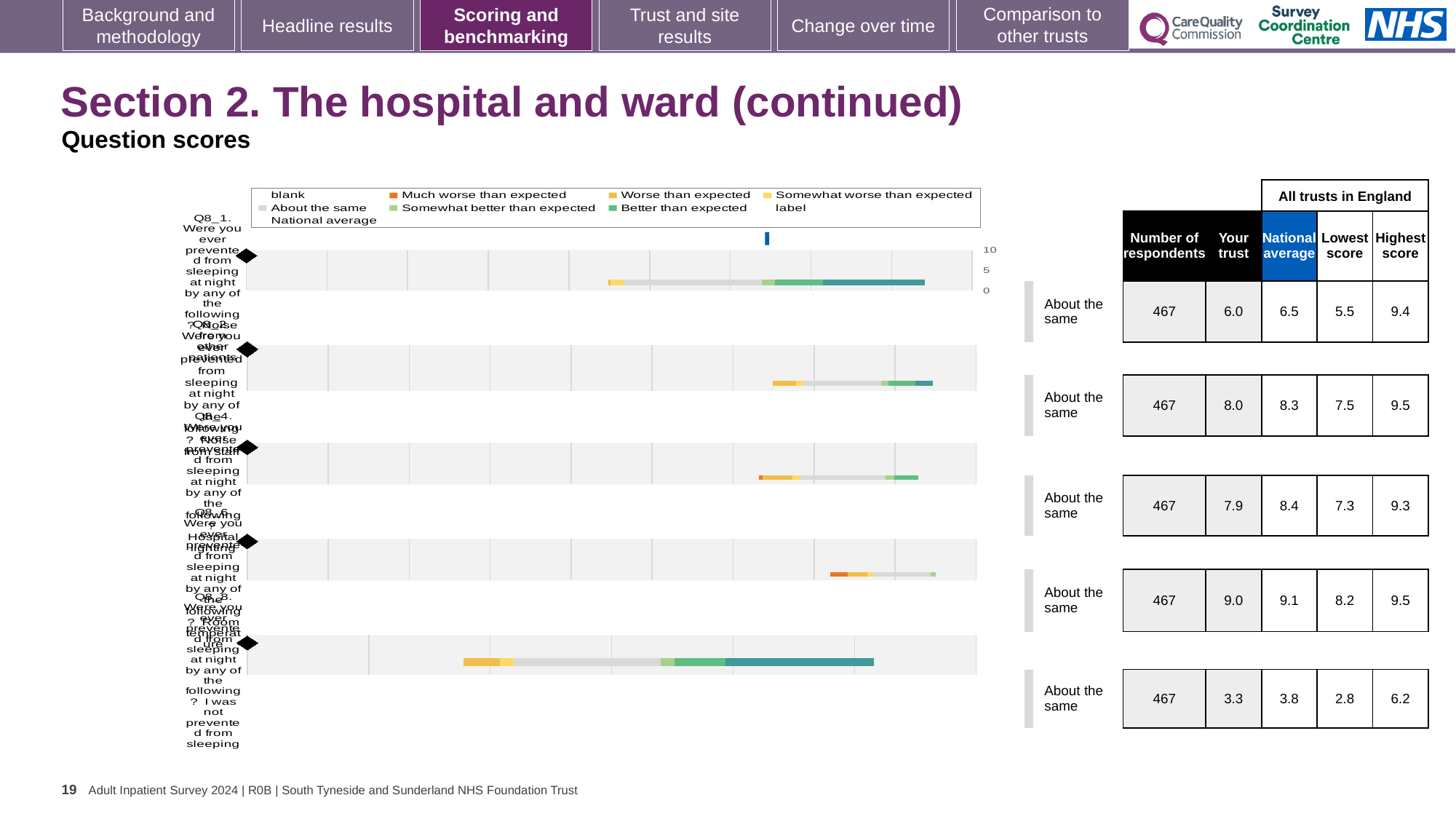
Is the 'Your trust' score for the second row (Q8_2) larger or smaller than its 'National average'? smaller What benchmark category is shown next to every chart row on the slide? About the same In the table beside the charts, what is the 'National average' for the first row (Q8_1)? 6.5 What kind of chart is used for the question score rows on this slide? bar chart In the table beside the charts, what is the 'Your trust' score for the first row (Q8_1)? 6.0 How many question score charts (rows) are shown on the slide? 5 In the table beside the charts, what is the 'Highest score' for the fourth row (Q8_6)? 9.5 Which row has the lowest 'Your trust' score in the table beside the charts? Q8_8 Which row has the highest 'Your trust' score in the table beside the charts? Q8_6 In the table beside the charts, what is the 'Your trust' score for the last row (Q8_8)? 3.3 What is the difference between the 'National average' and 'Your trust' score for the third row (Q8_4)? 0.5 How many respondents are listed for each chart row in the table? 467